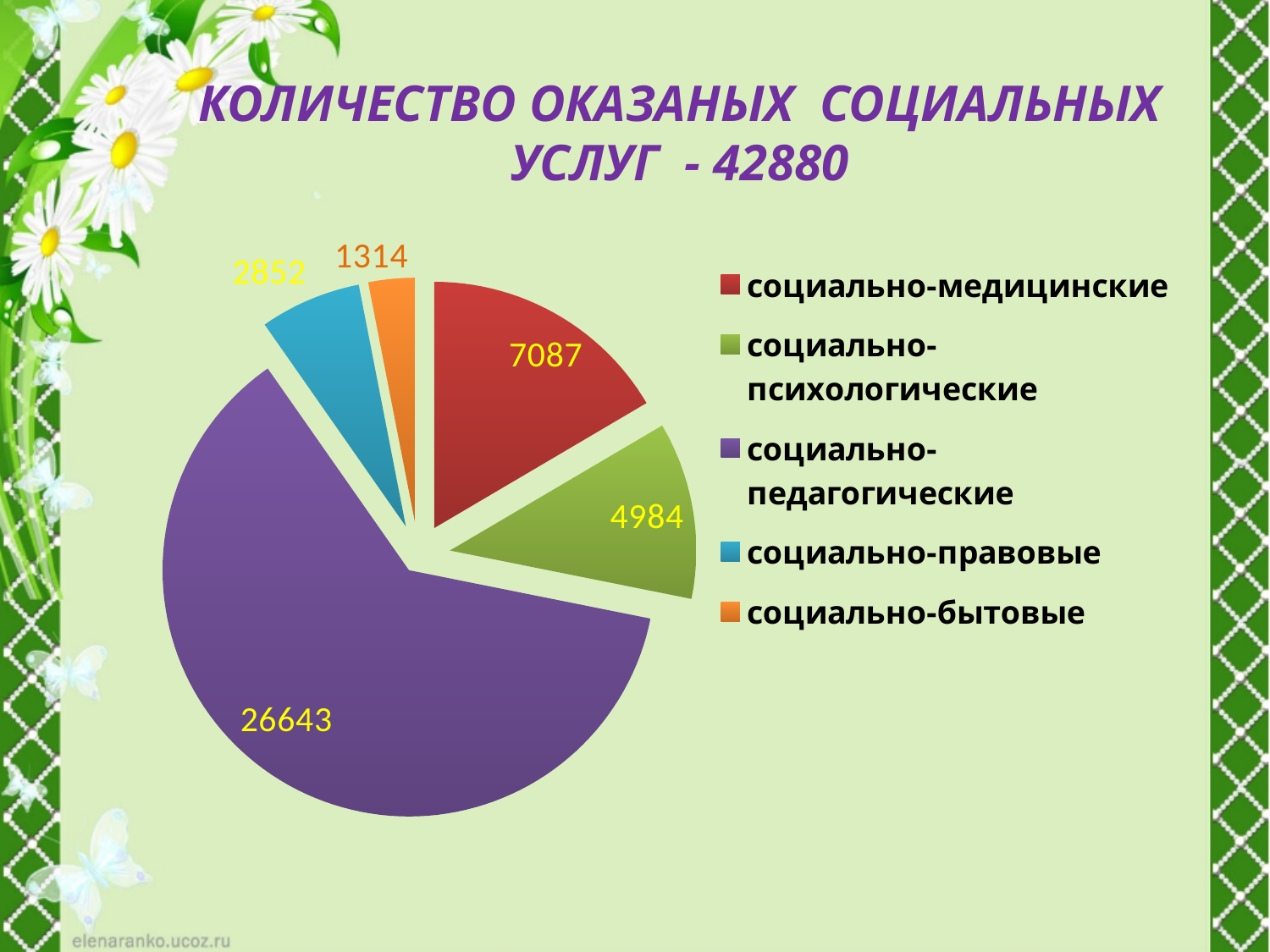
What is the value for социально-бытовые services? 1314 Which category has the smallest slice? социально-бытовые How many slices does the pie chart have? 5 What total number of services is stated in the chart title? 42880 Which category has the largest slice? социально-педагогические What is the value for социально-медицинские services? 7087 What is the difference between социально-медицинские and социально-психологические services? 2103 What kind of chart is shown on the slide? pie chart How many entries does the legend list? 5 What is the value for социально-педагогические services? 26643 Which is larger, социально-правовые or социально-бытовые? социально-правовые What is the value for социально-правовые services? 2852